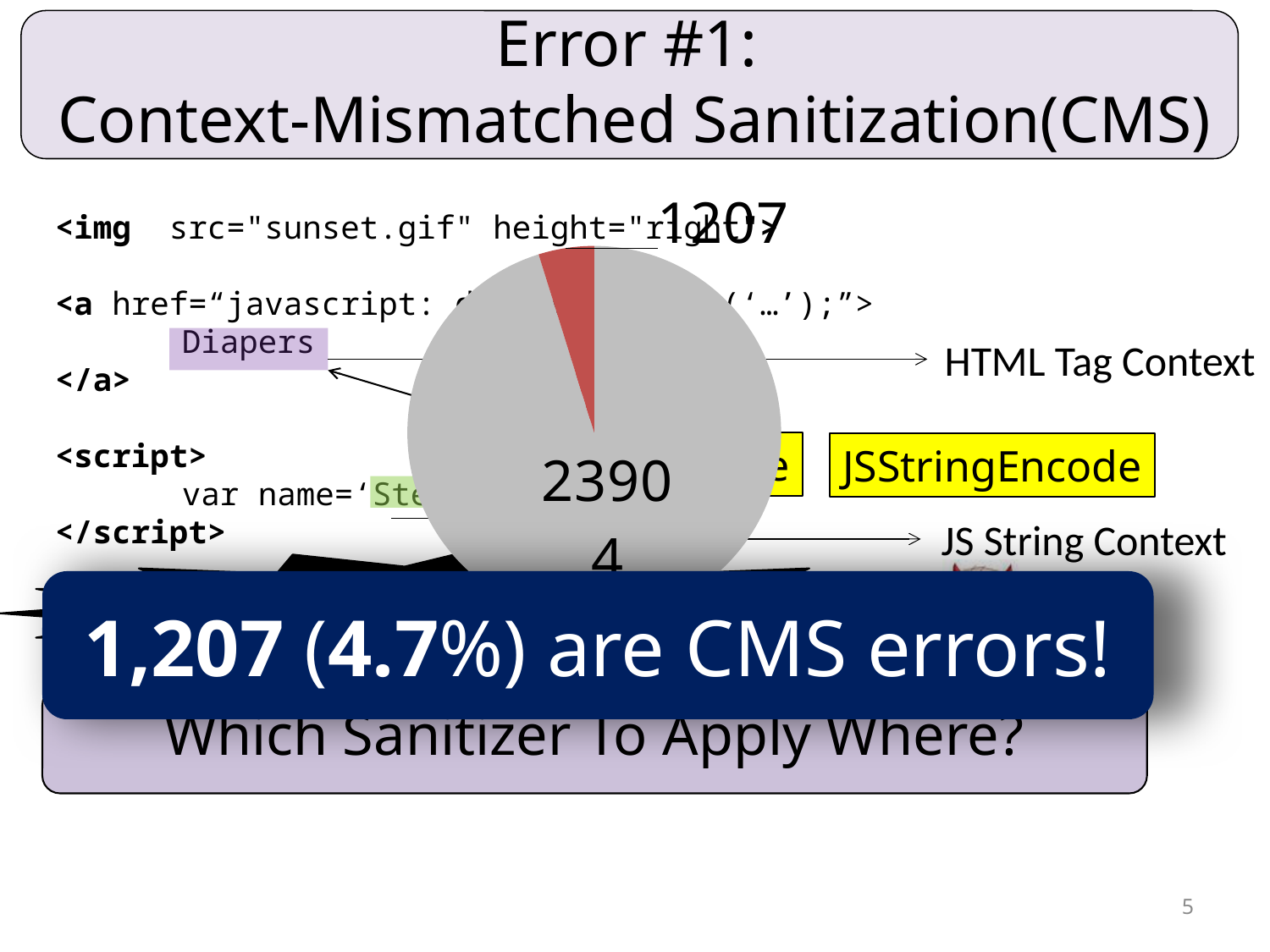
What value is labelled on the small red slice of the pie chart? 1207 What kind of chart is shown on the slide? pie chart What colour is the slice representing CMS errors in the pie chart? red Which is larger in the pie chart, the red slice or the gray slice? the gray slice According to the slide, how many CMS errors are there? 1,207 How many slices does the pie chart have? 2 What share of the pie do the CMS errors (the red slice) represent, according to the slide? 4.7% Which slice of the pie chart is the largest? the gray slice Which slice of the pie chart is the smallest? the red slice (1207)